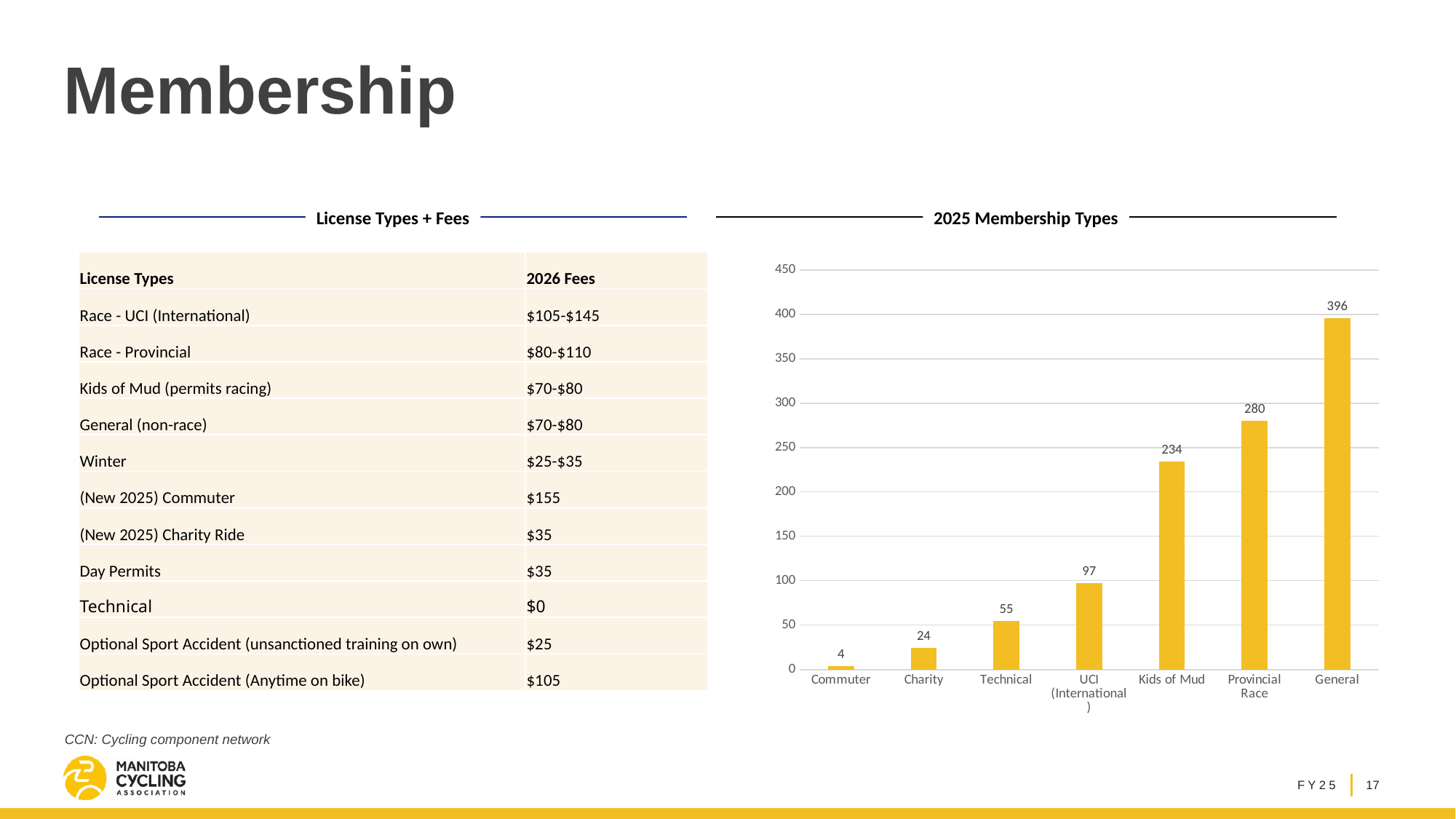
Is the value for Kids of Mud in the 2025 Membership Types chart greater or less than 200? greater What kind of chart is the 2025 Membership Types chart? bar chart Which is larger in the 2025 Membership Types chart, Kids of Mud or Provincial Race? Provincial Race What is the difference between Technical and Charity in the 2025 Membership Types chart? 31 What is the value for UCI (International) in the 2025 Membership Types chart? 97 Do the values in the 2025 Membership Types chart rise or fall from left to right along the x axis? rise Which category has the lowest value in the 2025 Membership Types chart? Commuter What is the value for Kids of Mud in the 2025 Membership Types chart? 234 What is the value for General in the 2025 Membership Types chart? 396 How many categories are shown in the 2025 Membership Types chart? 7 Which category has the highest value in the 2025 Membership Types chart? General What is the difference between General and Provincial Race in the 2025 Membership Types chart? 116